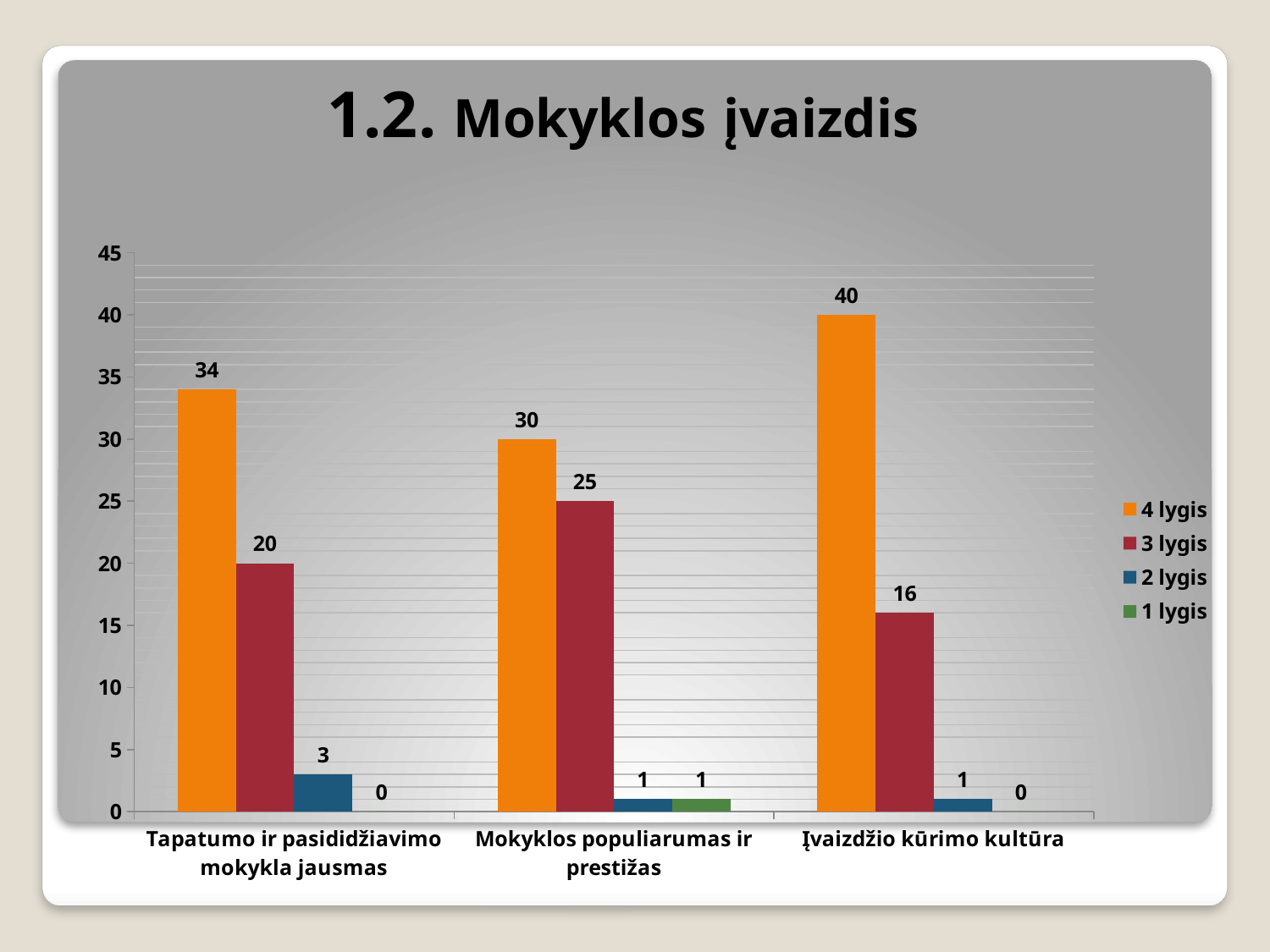
Which is larger: the 4 lygis value for Mokyklos populiarumas ir prestižas or the 4 lygis value for Tapatumo ir pasididžiavimo mokykla jausmas? Tapatumo ir pasididžiavimo mokykla jausmas What kind of chart is shown on the slide? Bar chart What is the value of the 2 lygis series for Tapatumo ir pasididžiavimo mokykla jausmas? 3 What is the value of the 4 lygis series for Įvaizdžio kūrimo kultūra? 40 What is the value of the 1 lygis series for Mokyklos populiarumas ir prestižas? 1 What is the value of the 3 lygis series for Mokyklos populiarumas ir prestižas? 25 What is the title of the slide? 1.2. Mokyklos įvaizdis Which category has the lowest value for the 3 lygis series? Įvaizdžio kūrimo kultūra Which category has the highest value for the 4 lygis series? Įvaizdžio kūrimo kultūra How many series does the legend list? 4 What is the difference between the 4 lygis and 3 lygis values for Tapatumo ir pasididžiavimo mokykla jausmas? 14 How many categories are shown on the x axis? 3